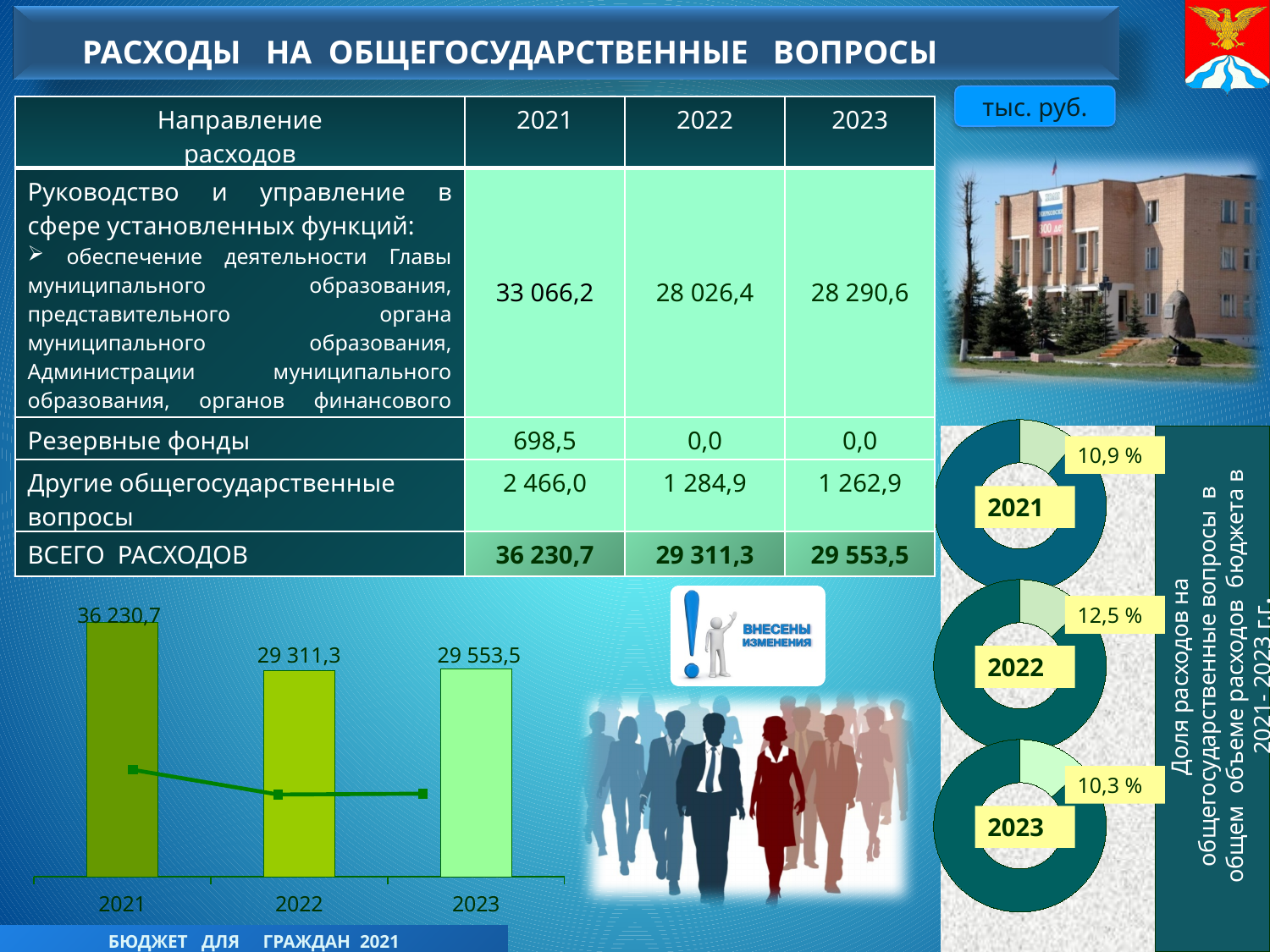
In the donut charts on the right, what share is shown for 2022? 12,5 % In the bar chart at the bottom left, what is the difference between the values for 2023 and 2022? 242,2 In the bar chart at the bottom left, which year has the lowest value? 2022 In the bar chart at the bottom left, what is the value shown for 2023? 29 553,5 In the bar chart at the bottom left, what is the value shown for 2022? 29 311,3 In the bar chart at the bottom left, what is the value shown for 2021? 36 230,7 In the bar chart at the bottom left, which year has the highest value? 2021 In the bar chart at the bottom left, does the value rise or fall from 2021 to 2022? fall What kind of chart is shown at the bottom left of the slide? bar chart In the bar chart at the bottom left, which is larger, the value for 2021 or the value for 2023? 2021 How many years are shown on the x axis of the bar chart at the bottom left? 3 In the bar chart at the bottom left, what is the difference between the values for 2021 and 2022? 6 919,4